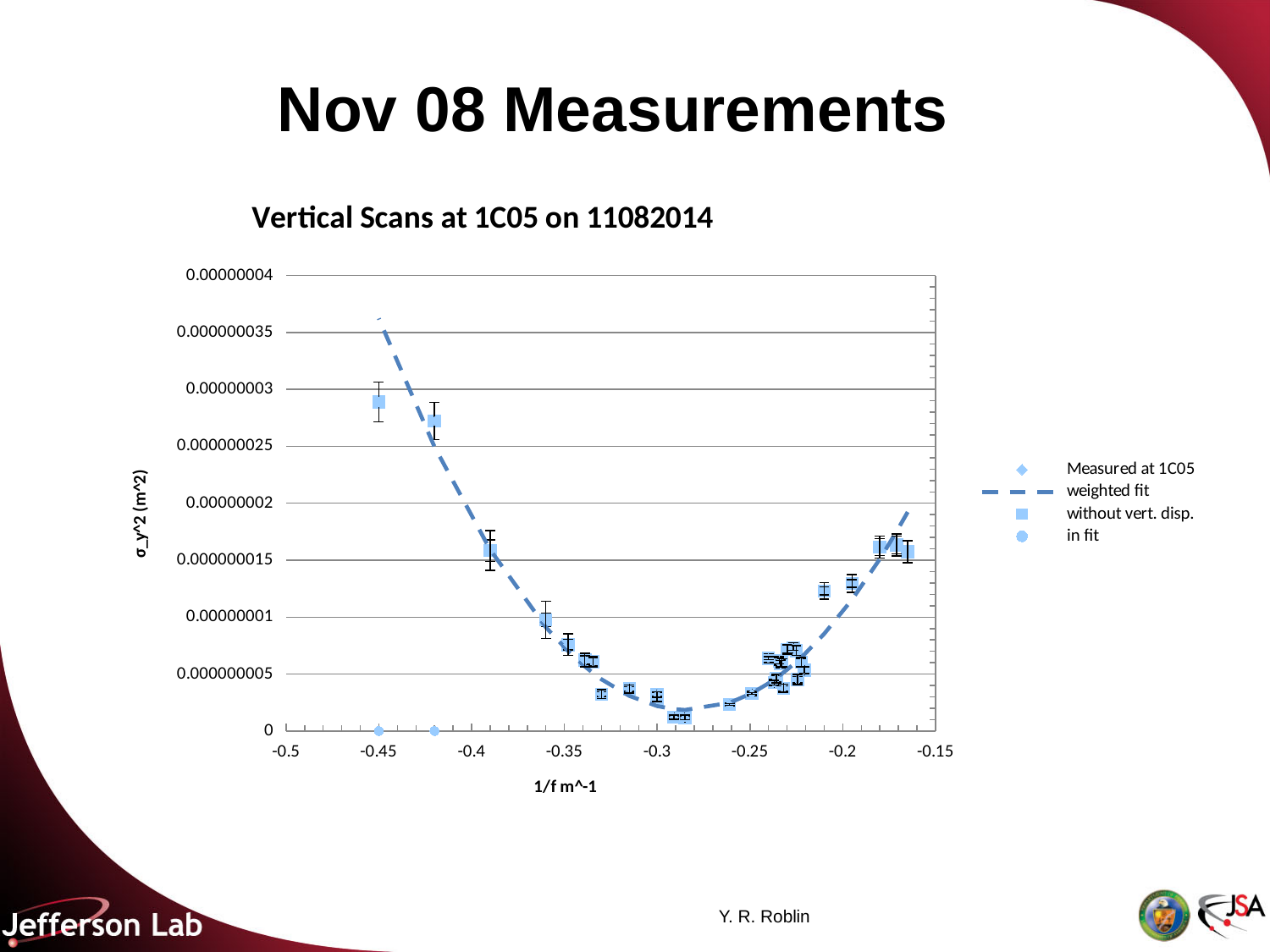
Is the value of the 'without vert. disp.' point at x = -0.45 greater or less than 0.000000025? greater What kind of chart is shown on the slide? scatter chart How many series does the chart legend list? 4 Which series is drawn as a dashed line? weighted fit Which is larger, the measured value at x = -0.45 or the measured value at x = -0.3? x = -0.45 Are the measured values near x = -0.18 greater or less than 0.00000001? greater What is the title of the chart? Vertical Scans at 1C05 on 11082014 Is the measured value at x = -0.39 greater or less than 0.00000002? less Do the plotted values rise or fall as x increases from -0.45 to -0.29? fall What is the label of the x axis? 1/f m^-1